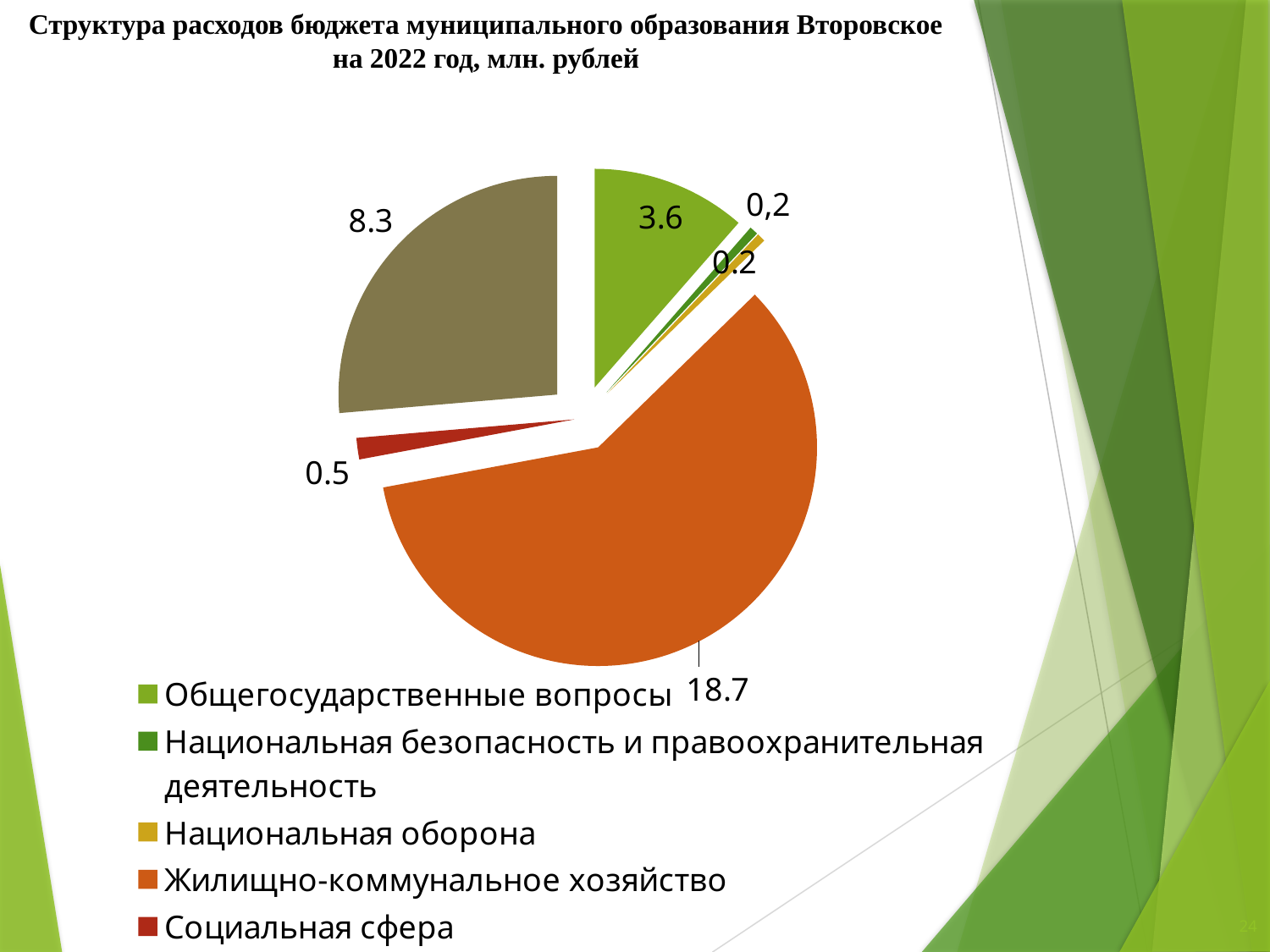
Which category has the largest slice of the pie? Жилищно-коммунальное хозяйство What is the value for Национальная безопасность и правоохранительная деятельность? 0,2 Which is larger, Общегосударственные вопросы or Социальная сфера? Общегосударственные вопросы What is the difference between the values for Жилищно-коммунальное хозяйство and Общегосударственные вопросы? 15.1 What is the value for Социальная сфера? 0.5 What kind of chart is shown on the slide? pie chart What colour is the slice for Жилищно-коммунальное хозяйство? orange What is the value for Общегосударственные вопросы? 3.6 What is the difference between the values for Общегосударственные вопросы and Социальная сфера? 3.1 How many slices does the pie chart have? 6 What is the value for Национальная оборона? 0.2 What is the value for Жилищно-коммунальное хозяйство? 18.7